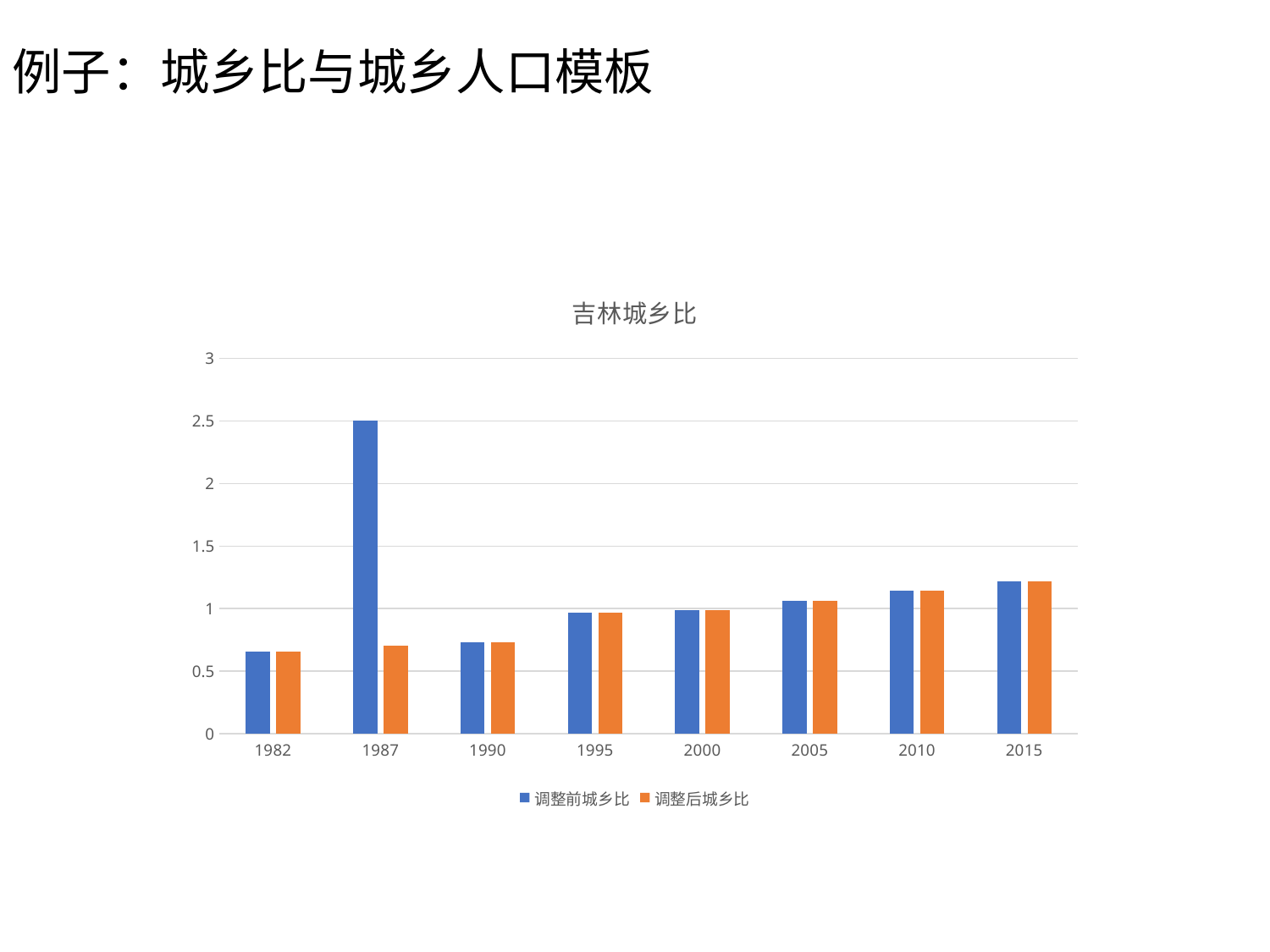
Does the 调整后城乡比 series generally rise or fall from 1982 to 2015? rise For 1987, which series has the larger value, 调整前城乡比 or 调整后城乡比? 调整前城乡比 Which year has the highest 调整前城乡比? 1987 Is the 调整后城乡比 value for 1982 greater or less than 1? less How many series does the legend list? 2 Is the 调整前城乡比 value for 1987 greater or less than 2? greater Which year has the larger 调整后城乡比 value, 1990 or 2015? 2015 How many years are shown on the x axis of the chart? 8 Is the 调整后城乡比 value for 1987 greater or less than 1? less Which year has the lowest 调整前城乡比? 1982 What kind of chart is shown on the slide? bar chart